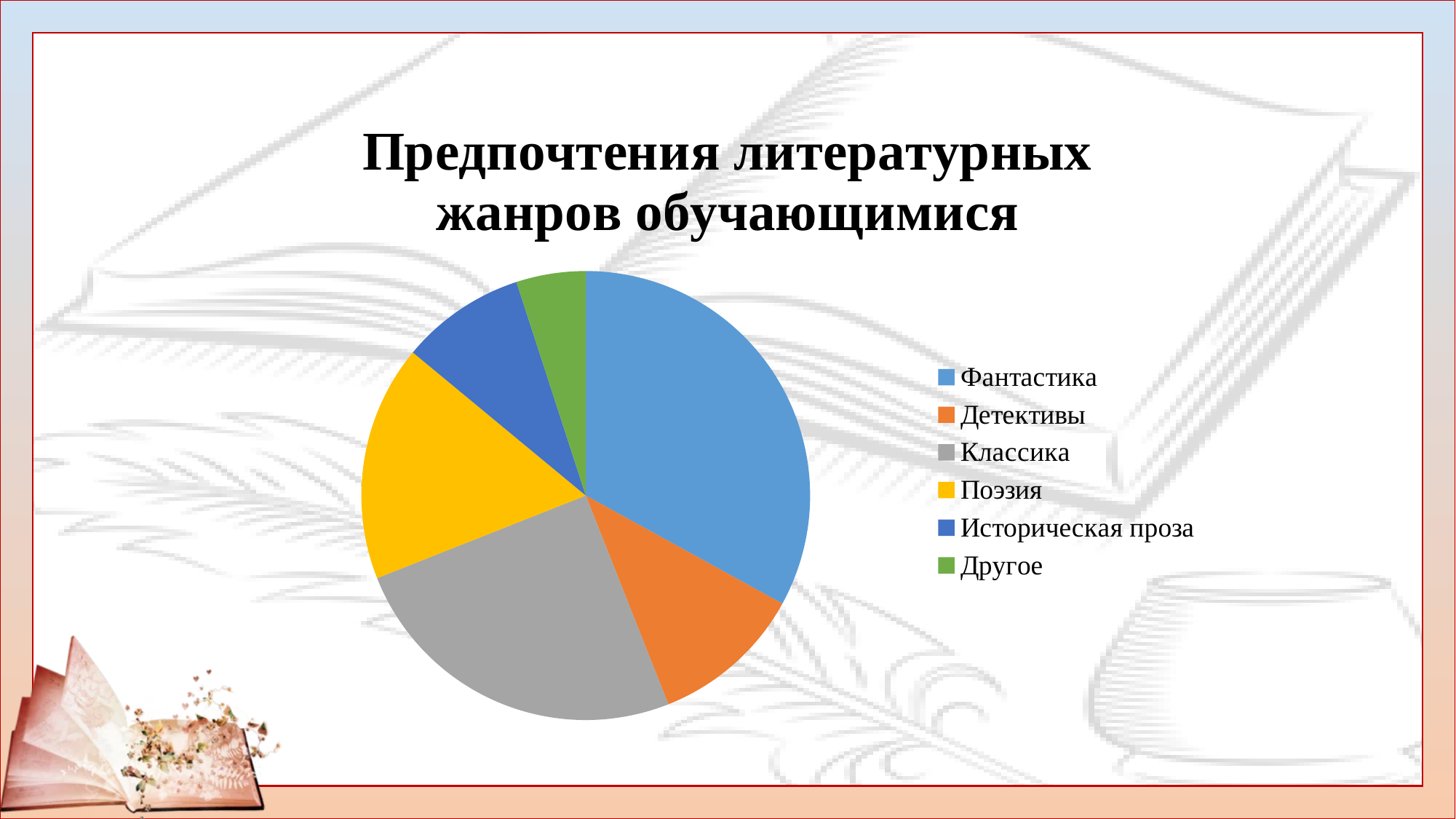
Which slice is larger, Классика or Поэзия? Классика Which genre has the largest slice of the pie? Фантастика How many categories (slices) does the pie chart have? 6 Which genre is listed last in the legend? Другое What colour is the slice for Поэзия? yellow What is the title of the chart? Предпочтения литературных жанров обучающимися Which slice is larger, Поэзия or Другое? Поэзия Which slice is larger, Детективы or Фантастика? Фантастика Which genre has the smallest slice of the pie? Другое What kind of chart is shown on the slide? pie chart